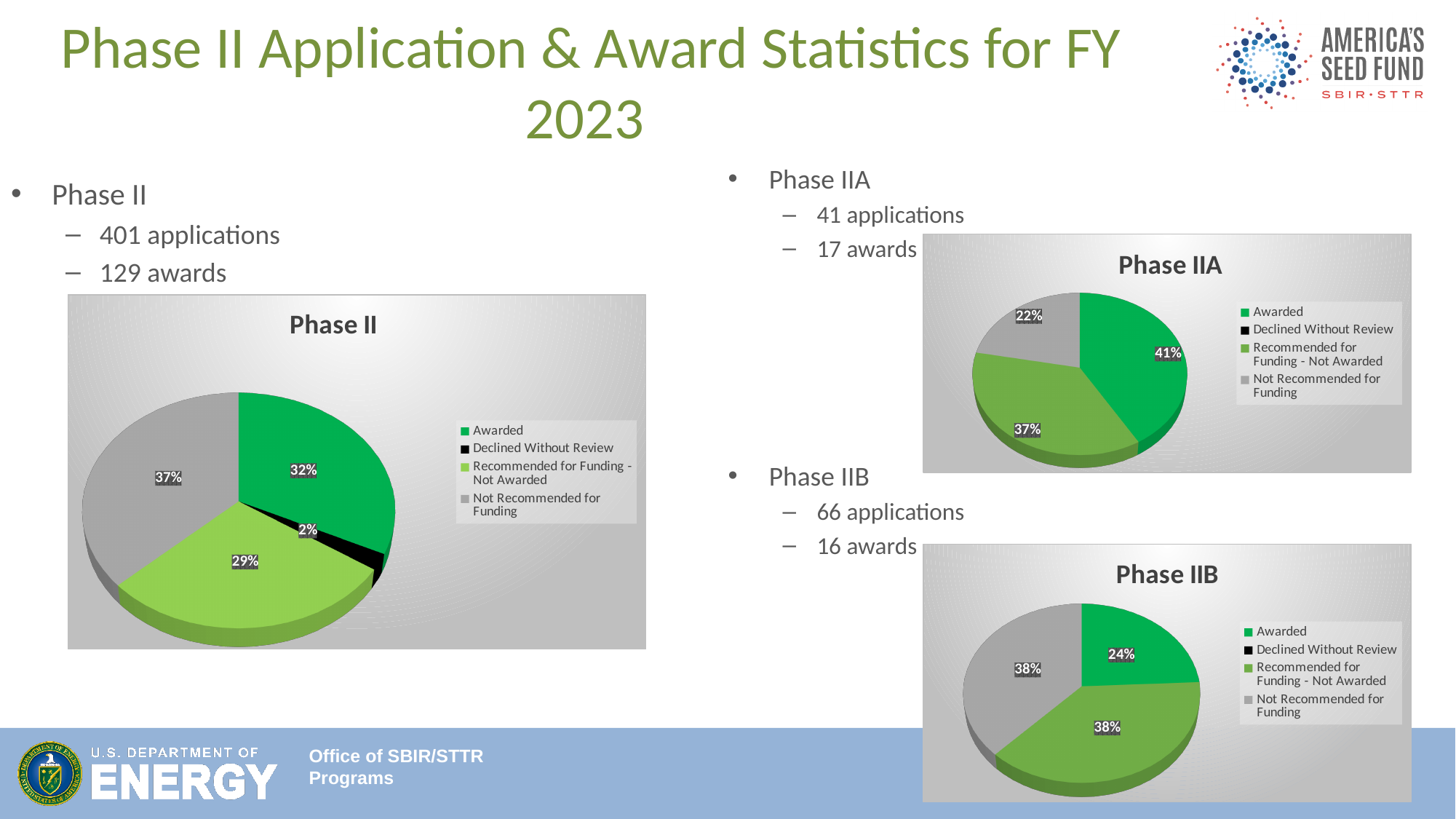
In the Phase II pie chart, what is the difference between the Not Recommended for Funding share and the Recommended for Funding - Not Awarded share? 8% How many entries does the legend of the Phase II chart list? 4 In the Phase IIB pie chart, is the Awarded slice larger or smaller than the Recommended for Funding - Not Awarded slice? smaller In the Phase IIB pie chart, what share is labelled for Awarded? 24% In the Phase II pie chart, which category has the smallest slice? Declined Without Review In the Phase IIA pie chart, what is the difference between the Awarded share and the Not Recommended for Funding share? 19% In the Phase II pie chart, what share is labelled for Awarded? 32% In the Phase IIA pie chart, what share is labelled for Awarded? 41% In the Phase II pie chart, what share is labelled for Declined Without Review? 2% In the Phase IIA pie chart, which category has the smallest labelled slice? Not Recommended for Funding In the Phase II pie chart, which category has the largest slice? Not Recommended for Funding What type of chart is used for Phase IIB? pie chart